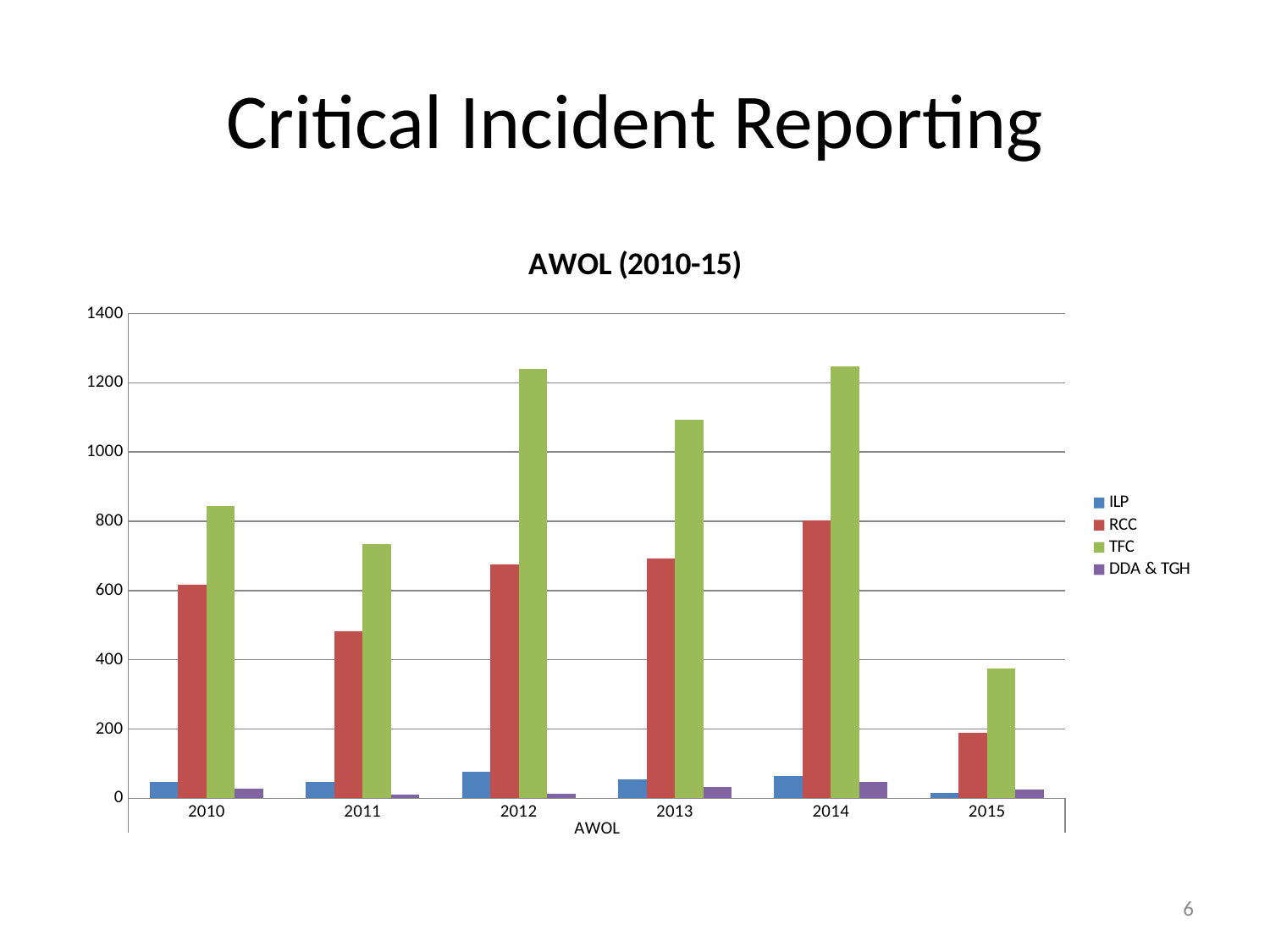
How many years are shown on the x axis? 6 How many series does the legend list? 4 Is the RCC value for 2014 greater or less than 1000? less In which year is the TFC value lowest? 2015 What kind of chart is shown on the slide? bar chart Is the RCC value for 2011 greater or less than 600? less In which year is the RCC value highest? 2014 Which series is shown in green in the legend? TFC Which is larger, the TFC value for 2011 or the TFC value for 2013? 2013 Is the TFC value for 2015 greater or less than 400? less What is the title of the chart? AWOL (2010-15)